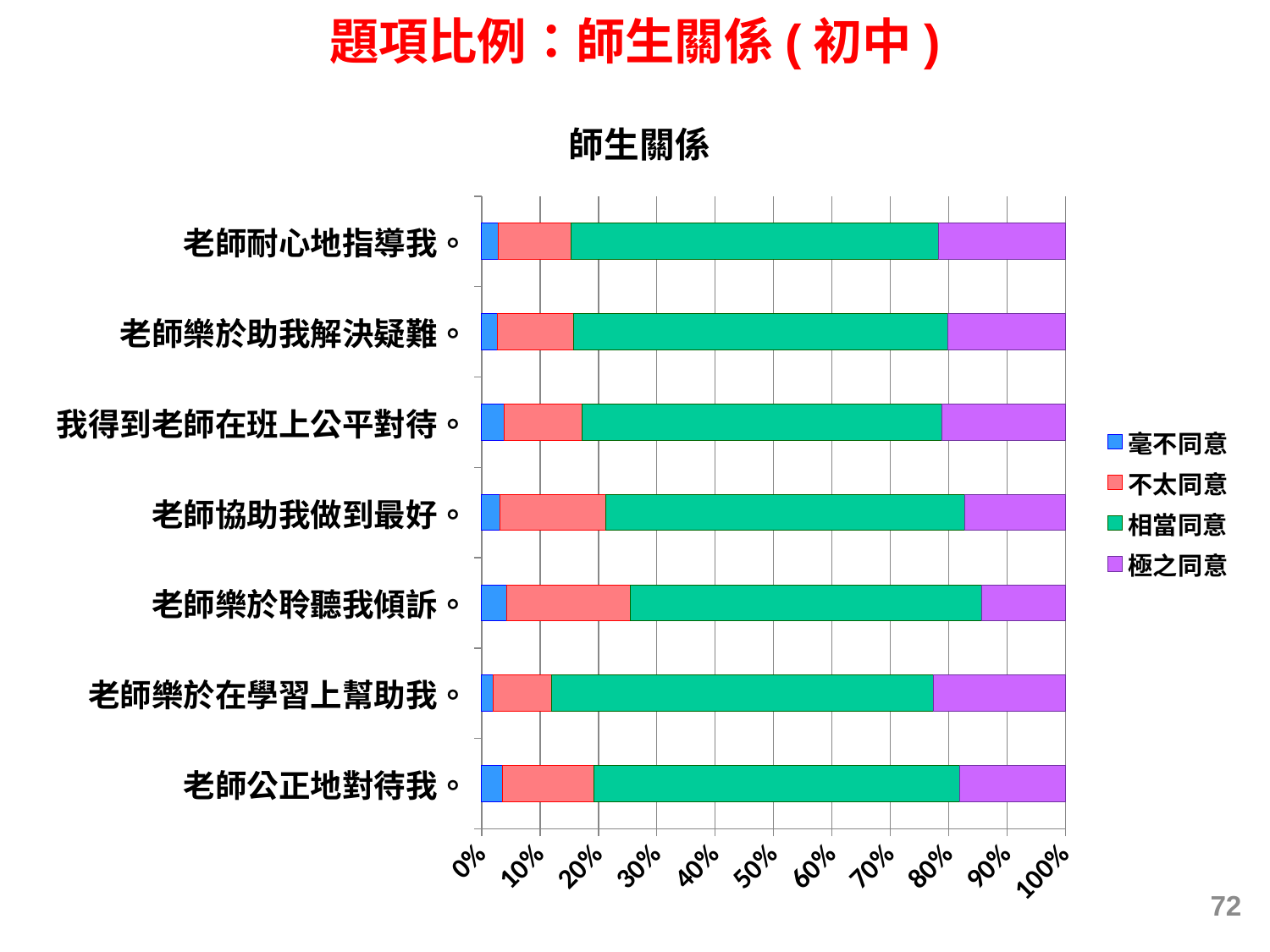
How many series does the legend list? 4 Which statement has the largest 不太同意 share? 老師樂於聆聽我傾訴 Which has the larger 不太同意 share: 老師樂於聆聽我傾訴 or 老師樂於在學習上幫助我? 老師樂於聆聽我傾訴 Which legend entry is shown in green? 相當同意 Is the 相當同意 share for 老師耐心地指導我 greater or less than 50%? greater What is the title of the chart? 師生關係 What is the total of each stacked bar on the chart? 100% Is the 極之同意 share for 老師樂於聆聽我傾訴 greater or less than 20%? less What kind of chart is shown on the slide? Stacked bar chart Is the 極之同意 share for 老師樂於在學習上幫助我 greater or less than 30%? less How many statements (categories) are plotted on the chart? 7